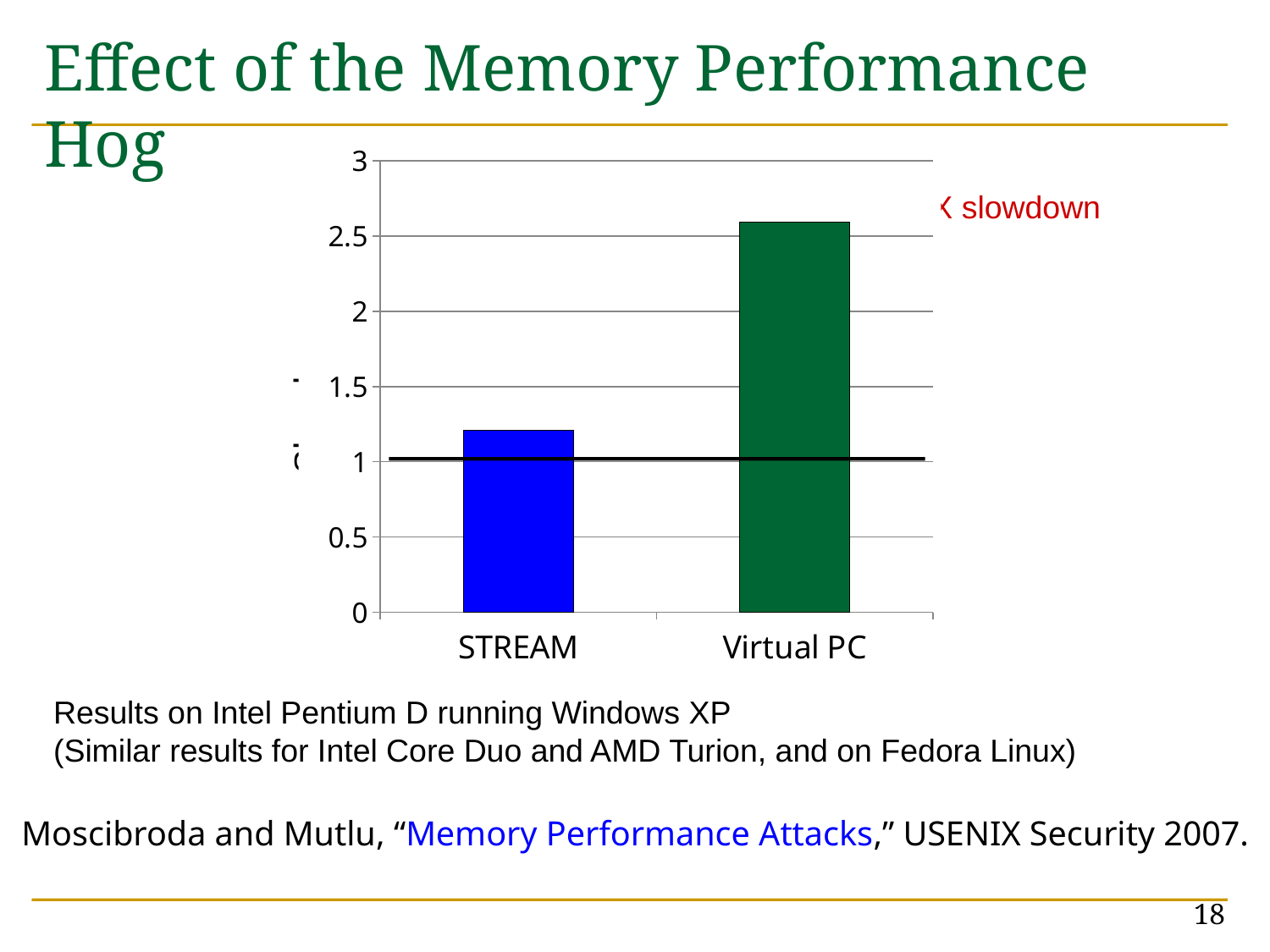
How many categories are plotted on the x axis of the chart? 2 What colour is the bar for STREAM? blue Is the value for Virtual PC greater or less than 2? greater Is the value for STREAM greater or less than 1? greater Do the bar values rise or fall from STREAM to Virtual PC? rise Which bar is taller, STREAM or Virtual PC? Virtual PC What is the highest tick value shown on the y axis of the chart? 3 Is the value for STREAM greater or less than 1.5? less What kind of chart is shown on the slide? bar chart Which category has the highest bar in the chart? Virtual PC Which category has the lowest bar in the chart? STREAM